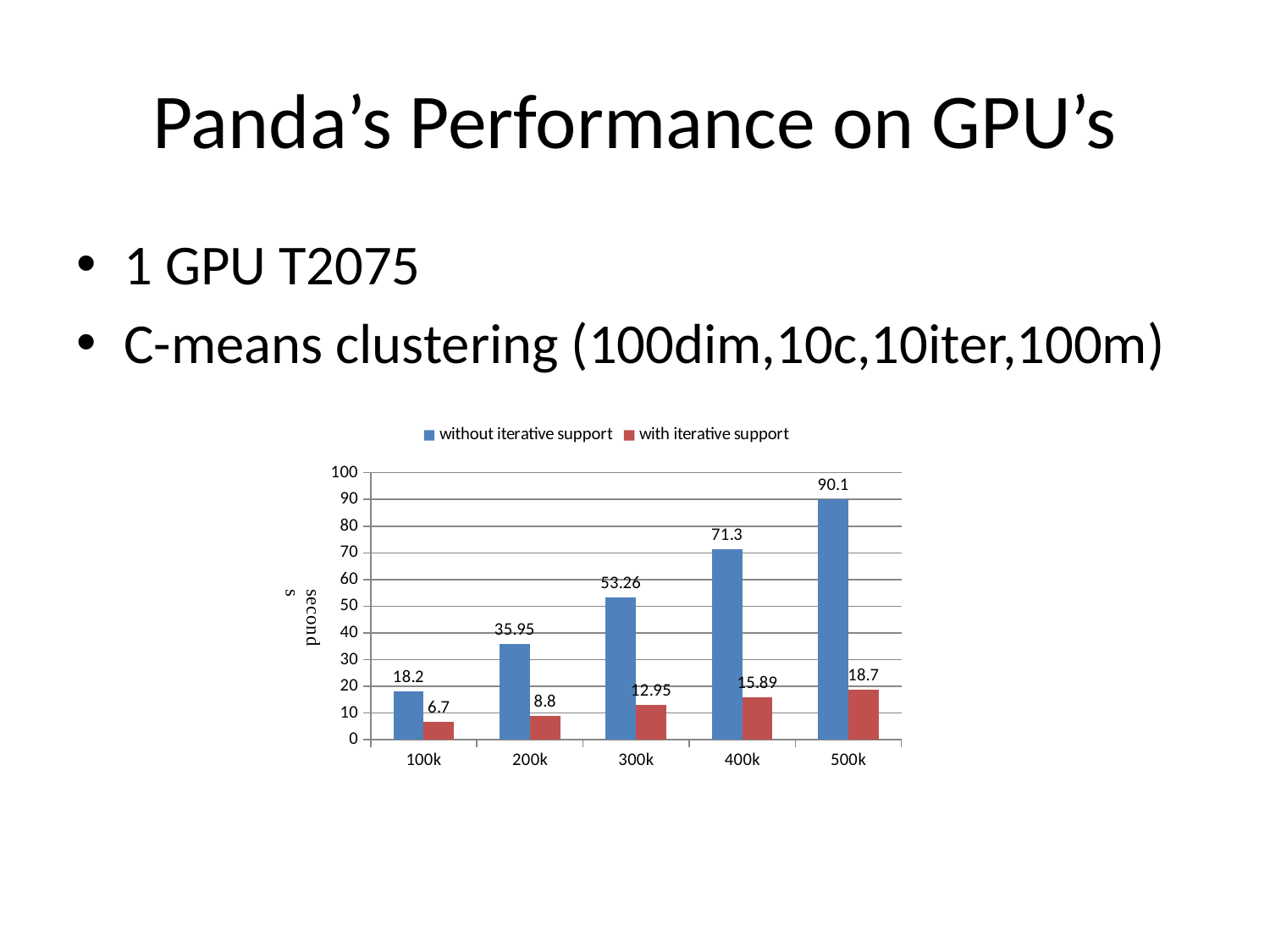
Which category has the lowest value for 'with iterative support'? 100k Do the values for 'without iterative support' rise or fall from 100k to 500k? rise What is the value for 'with iterative support' at 400k? 15.89 What is the value for 'with iterative support' at 100k? 6.7 What kind of chart is shown on the slide? bar chart How many categories are shown on the x axis? 5 What is the difference between 'without iterative support' at 200k and at 100k? 17.75 How many series does the legend list? 2 Which category has the highest value for 'without iterative support'? 500k What is the value for 'without iterative support' at 300k? 53.26 Which is larger at 200k: 'without iterative support' or 'with iterative support'? without iterative support What is the difference between 'without iterative support' and 'with iterative support' at 500k? 71.4